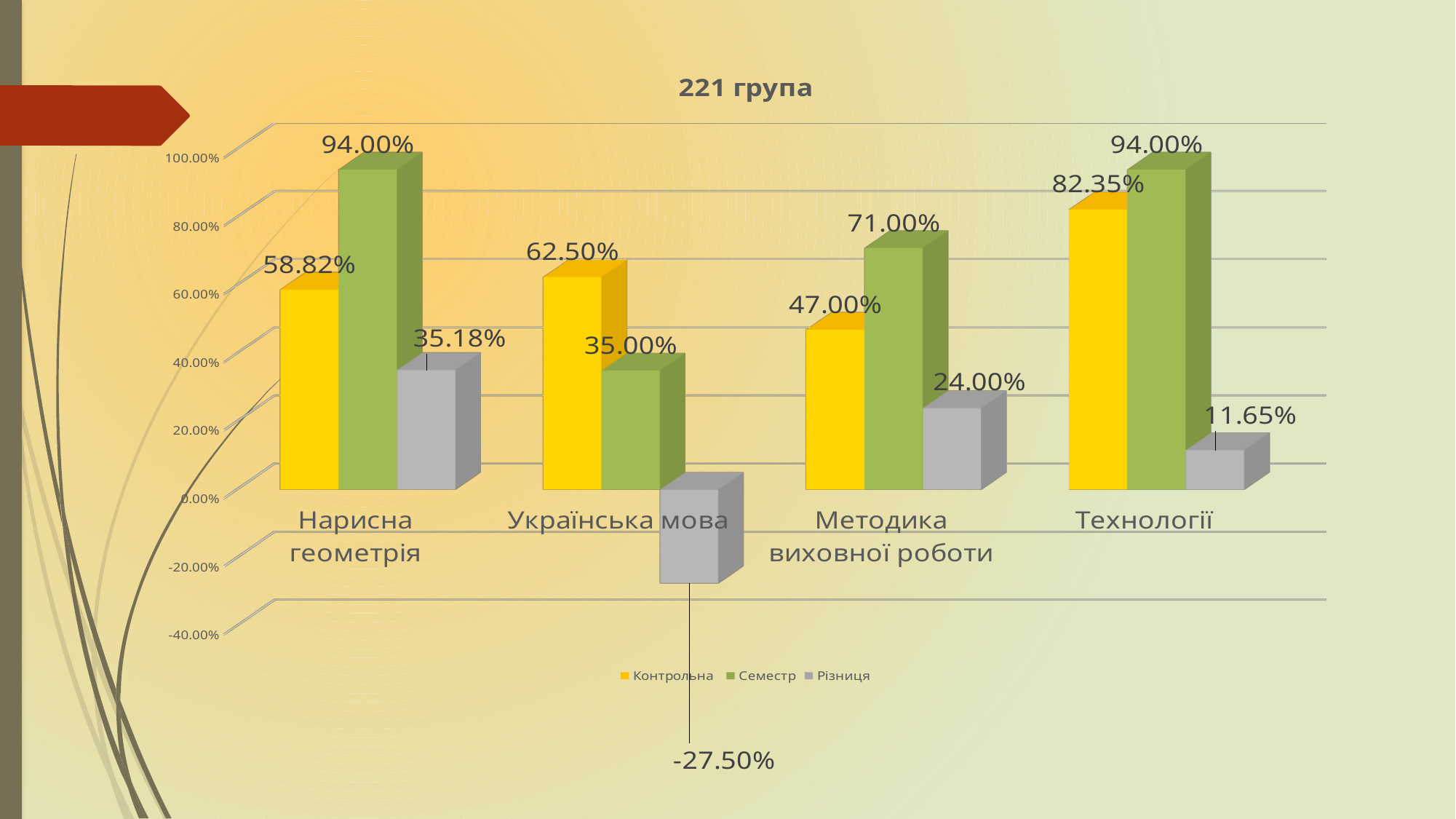
What kind of chart is shown on the slide? Bar chart What is the Контрольна value for Технології? 82.35% How many series does the legend list? 3 Which category has the lowest Семестр value? Українська мова How many categories are shown on the x axis? 4 What is the Семестр value for Методика виховної роботи? 71.00% Which category has the highest Контрольна value? Технології What is the title of the chart? 221 група Which is larger for Українська мова: the Контрольна value or the Семестр value? Контрольна What is the Різниця value for Українська мова? -27.50% What is the Контрольна value for Нарисна геометрія? 58.82% What is the difference between the Семестр and Контрольна values for Методика виховної роботи? 24.00%